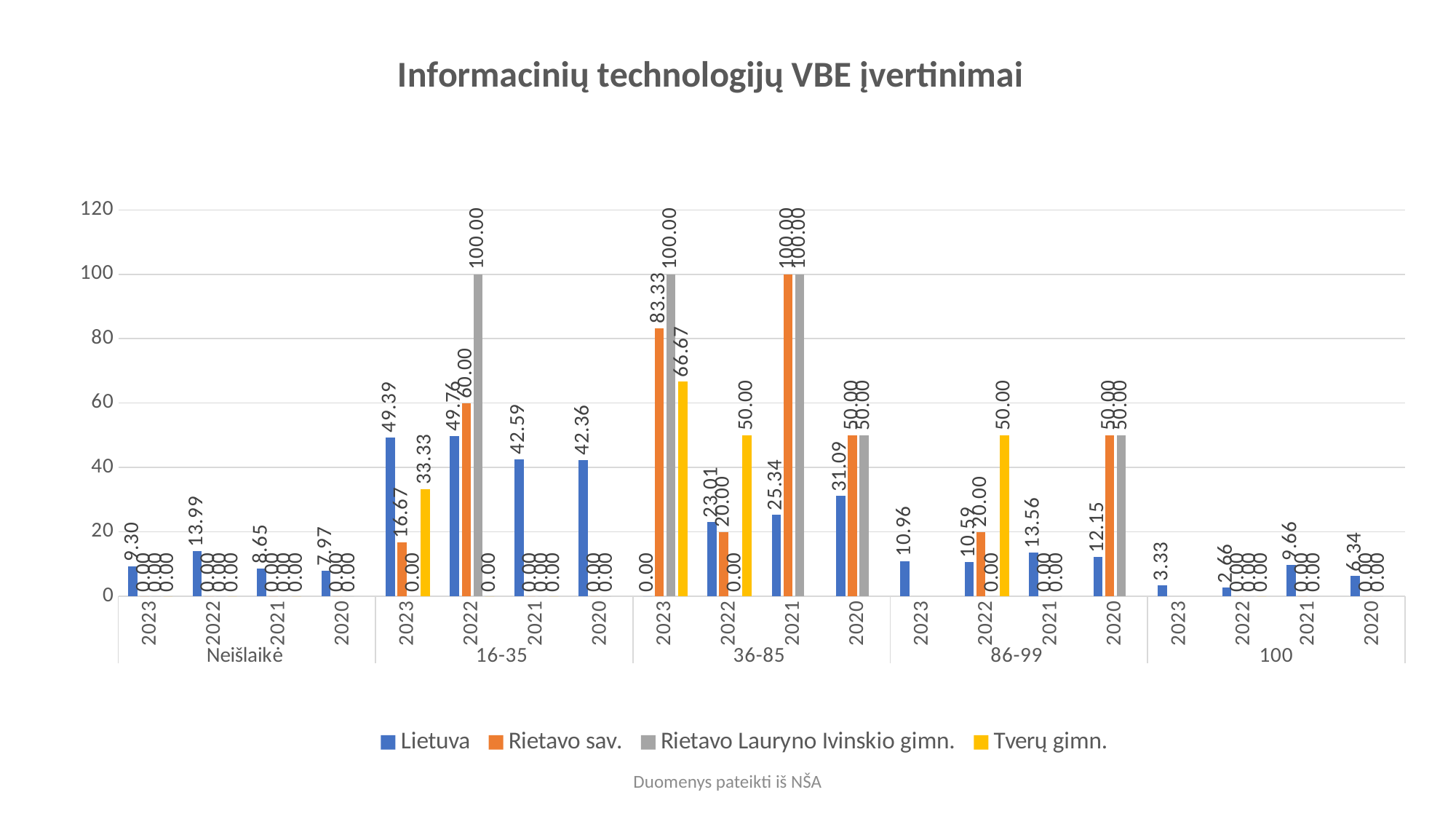
In the Neišlaikė group, which year has the highest value for Lietuva? 2022 What is the title of the chart? Informacinių technologijų VBE įvertinimai How many series does the legend list? 4 What is the value for Rietavo sav. in the 36-85 group for 2023? 83.33 In the 100 group, which year has the lowest value for Lietuva? 2022 In the 36-85 group for 2022, which is larger: the Lietuva value or the Tverų gimn. value? Tverų gimn. What is the value for Tverų gimn. in the 16-35 group for 2023? 33.33 What is the difference between the Rietavo sav. value and the Lietuva value in the 16-35 group for 2022? 10.24 How many score groups are shown along the x axis? 5 What is the value for Lietuva in the Neišlaikė group for 2022? 13.99 What is the value for Lietuva in the 100 group for 2021? 9.66 What kind of chart is shown on the slide? Bar chart